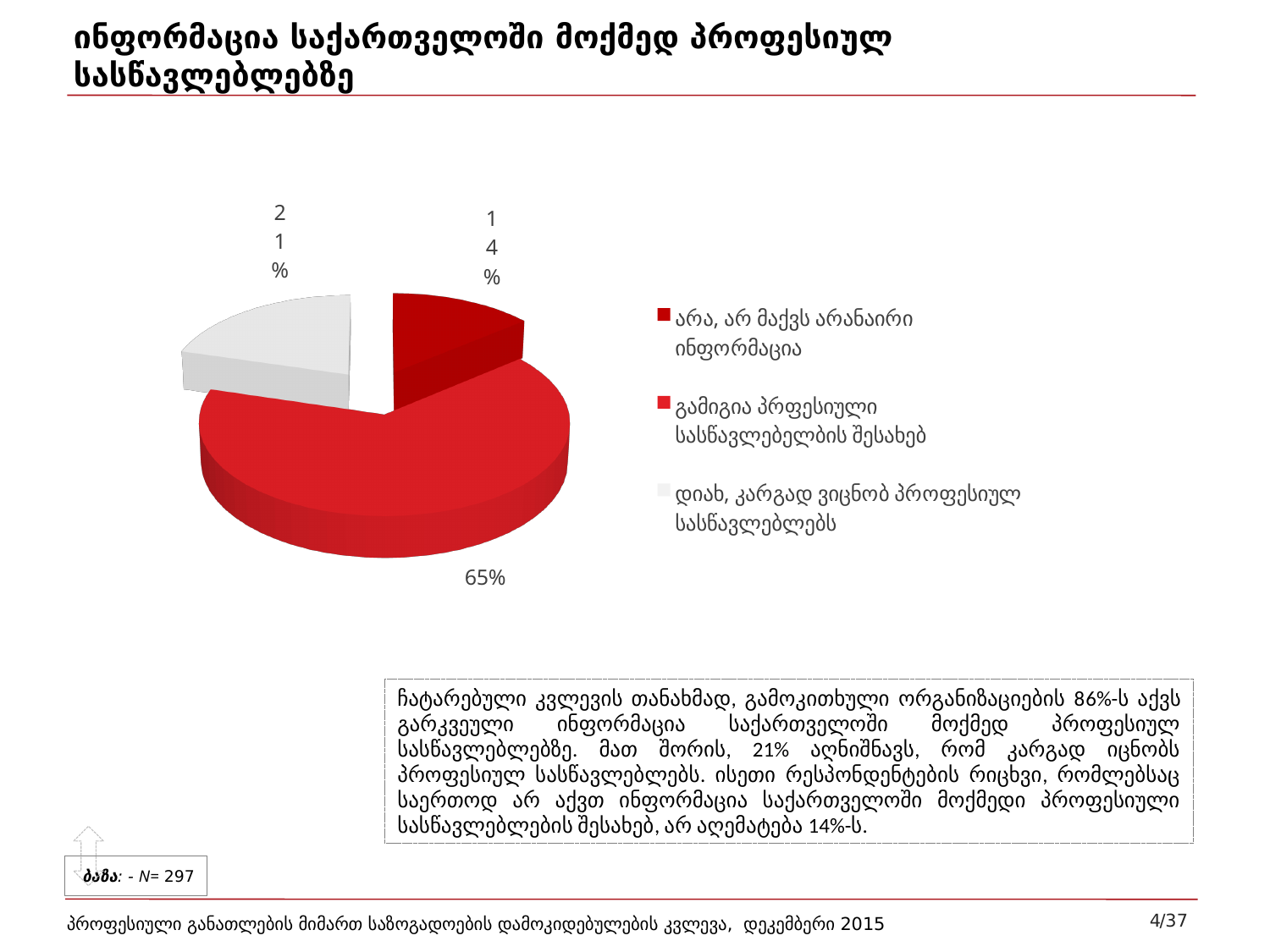
How many slices does the pie chart have? 3 Which is larger: the slice for "დიახ, კარგად ვიცნობ პროფესიულ სასწავლებლებს" or the slice for "არა, არ მაქვს არანაირი ინფორმაცია"? დიახ, კარგად ვიცნობ პროფესიულ სასწავლებლებს What is the difference in percentage points between the 65% slice and the 21% slice? 44 Which category has the smallest slice of the pie? არა, არ მაქვს არანაირი ინფორმაცია What kind of chart is shown on the slide? pie chart How many entries does the legend of the pie chart list? 3 Which category has the largest slice of the pie? გამიგია პრფესიული სასწავლებელბის შესახებ What share of the pie is labelled for "გამიგია პროფესიული სასწავლებლების შესახებ"? 65% What colour is the slice for "დიახ, კარგად ვიცნობ პროფესიულ სასწავლებლებს"? light gray What is the combined share of the two smaller slices (14% and 21%)? 35% What share of the pie is labelled for "დიახ, კარგად ვიცნობ პროფესიულ სასწავლებლებს"? 21% What share of the pie is labelled for "არა, არ მაქვს არანაირი ინფორმაცია"? 14%